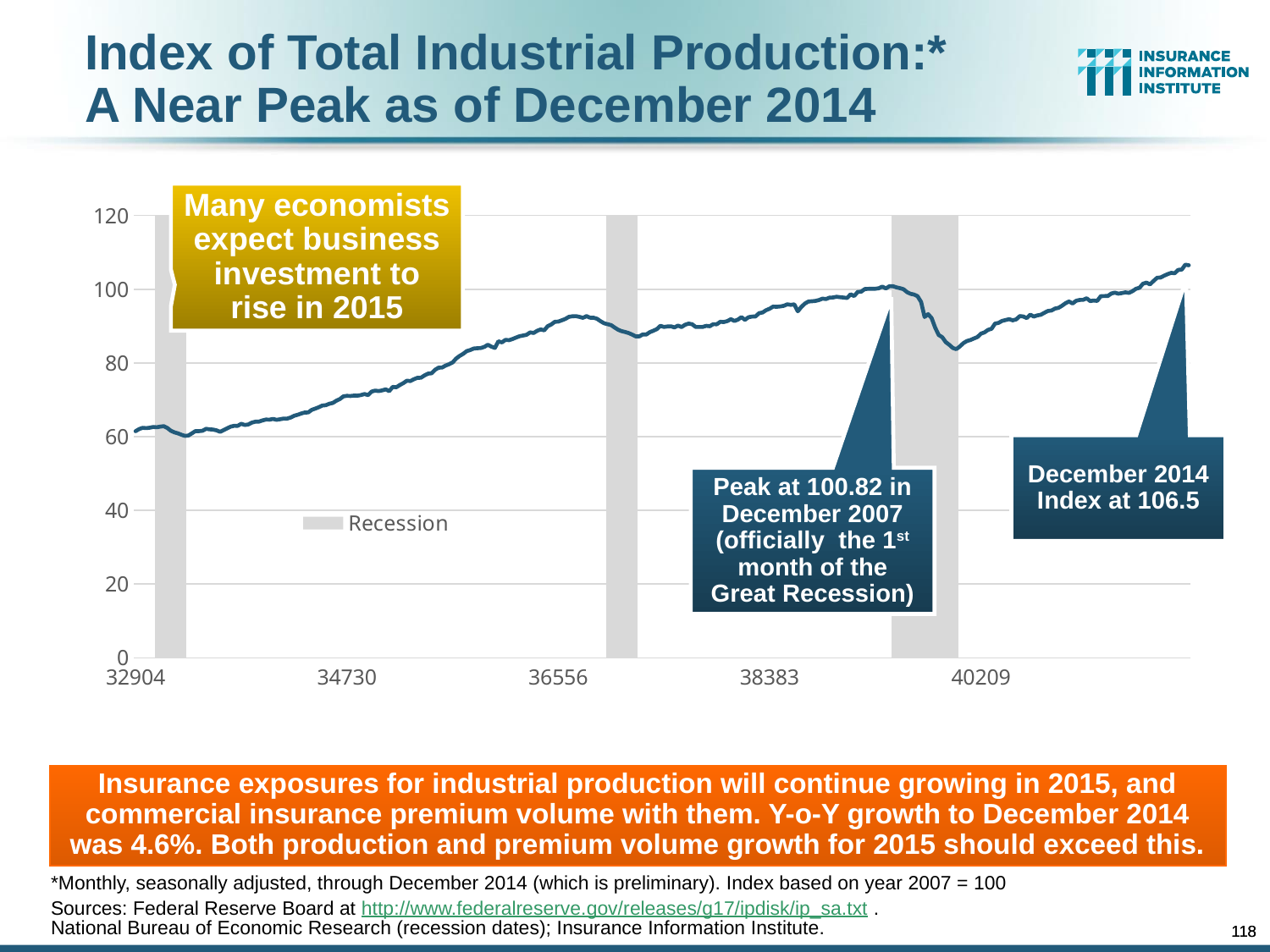
Is the index value at the x-axis label 40209 greater or less than 100? less Is the index value at the start of the series (x-axis label 32904) greater or less than 80? less By how much does the December 2014 index value exceed the December 2007 peak? 5.68 What kind of chart is shown on the slide? line chart How many grey shaded recession bands appear on the chart? 3 What does the grey shading on the chart represent, according to the legend? Recession What is the highest value shown on the chart's vertical axis? 120 What was the peak value of the index in December 2007? 100.82 Which is higher: the index in December 2007 or in December 2014? December 2014 What was the Index of Total Industrial Production in December 2014? 106.5 Does the index generally rise or fall from the left of the chart to the right? rise Is the index value at the x-axis label 36556 greater or less than 80? greater